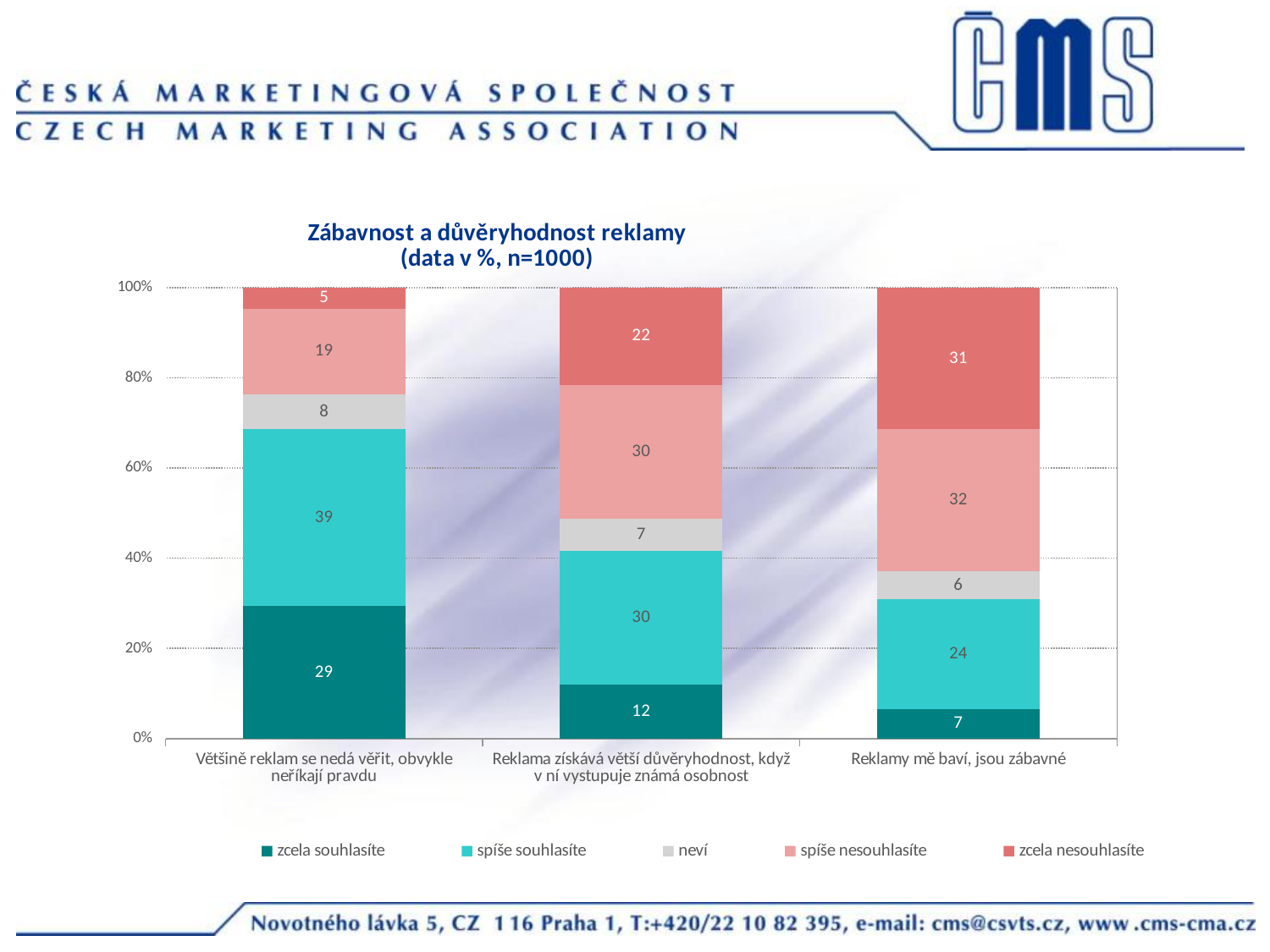
What is the difference between the "spíše nesouhlasíte" values for "Reklamy mě baví, jsou zábavné" and "Většině reklam se nedá věřit, obvykle neříkají pravdu"? 13 Do the "zcela souhlasíte" values rise or fall from left to right across the categories? Fall What is the value for "zcela souhlasíte" in the category "Většině reklam se nedá věřit, obvykle neříkají pravdu"? 29 How many series does the legend list? 5 Which is larger: "zcela souhlasíte" for "Reklama získává větší důvěryhodnost, když v ní vystupuje známá osobnost" or "zcela souhlasíte" for "Reklamy mě baví, jsou zábavné"? Reklama získává větší důvěryhodnost, když v ní vystupuje známá osobnost Which category has the highest value for "spíše souhlasíte"? Většině reklam se nedá věřit, obvykle neříkají pravdu How many categories are shown on the x axis? 3 What is the value for "zcela nesouhlasíte" in the category "Reklamy mě baví, jsou zábavné"? 31 What kind of chart is shown on the slide? Stacked bar chart What is the title of the chart? Zábavnost a důvěryhodnost reklamy (data v %, n=1000) What is the value for "neví" in the category "Reklama získává větší důvěryhodnost, když v ní vystupuje známá osobnost"? 7 Which category has the lowest value for "zcela nesouhlasíte"? Většině reklam se nedá věřit, obvykle neříkají pravdu